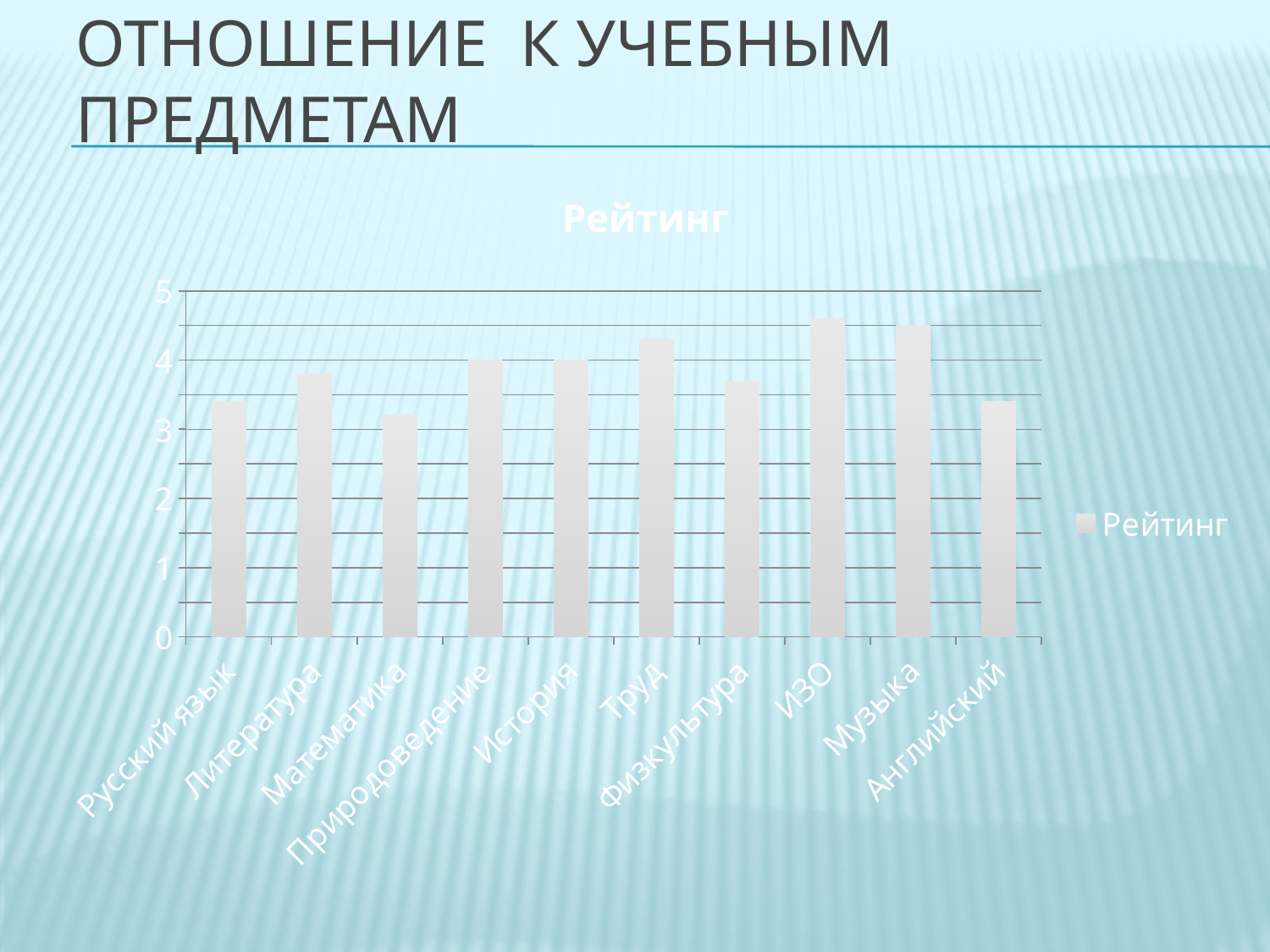
Which subject has the lowest rating in the chart? Математика Is the value for Русский язык greater or less than 4? less Is the value for Труд greater or less than 4? greater Is the value for Музыка greater or less than 3? greater Which has the larger value, Литература or Английский? Литература What is the title of the chart? Рейтинг What kind of chart is shown on the slide? bar chart How many series does the chart's legend list? 1 How many categories (subjects) are shown on the x axis of the chart? 10 Which has the larger value, Труд or Математика? Труд